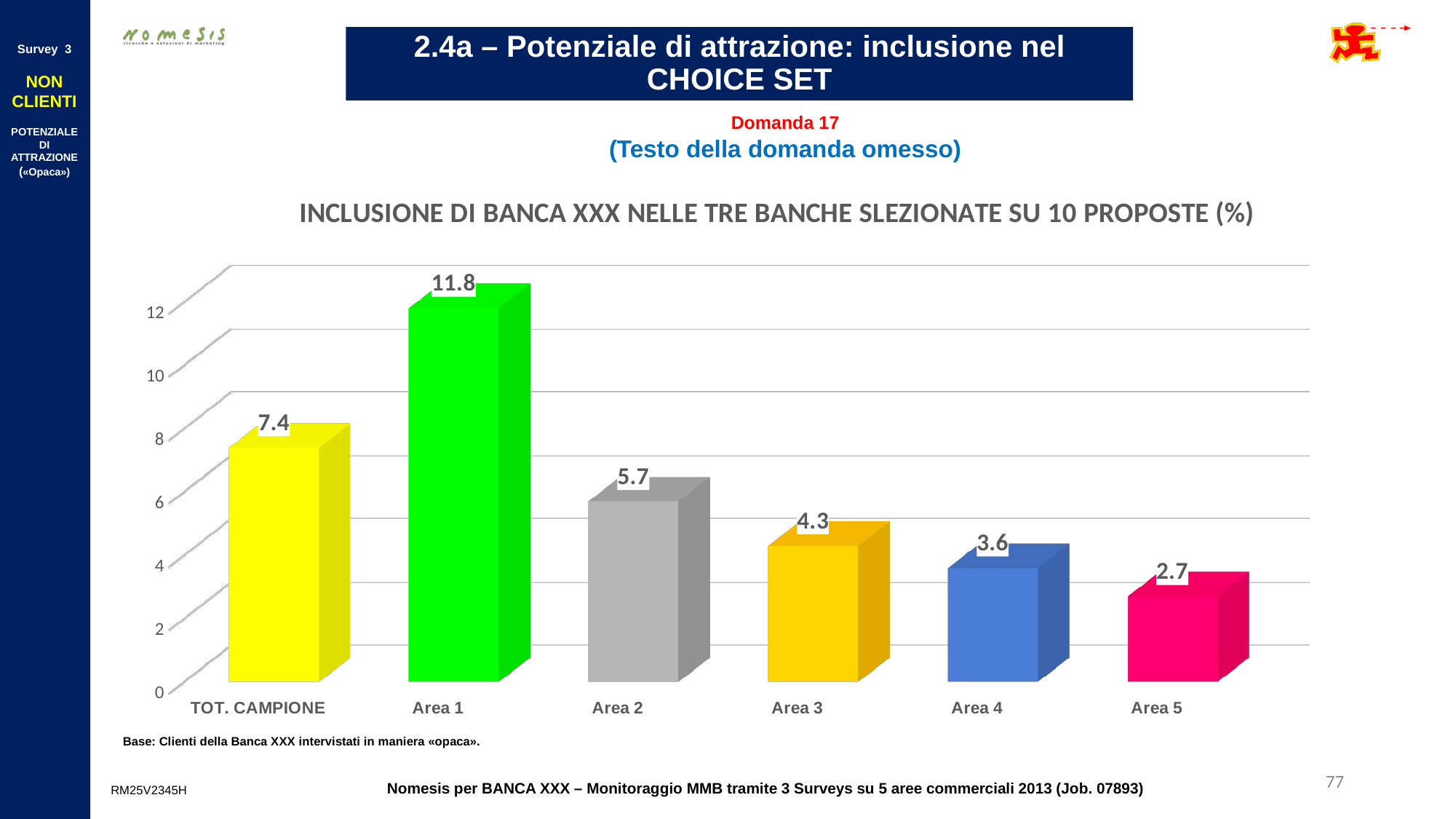
How many categories are shown on the x axis? 6 What is the value for Area 4? 3.6 What is the difference between the values for TOT. CAMPIONE and Area 5? 4.7 Which is larger, the value for Area 3 or the value for Area 4? Area 3 What colour is the bar for Area 1? green What is the value for TOT. CAMPIONE? 7.4 What kind of chart is shown on the slide? bar chart Is the value for Area 2 greater or less than 6? less Which category has the lowest value? Area 5 What is the difference between the values for Area 1 and Area 2? 6.1 What is the value for Area 1? 11.8 Which category has the highest value? Area 1